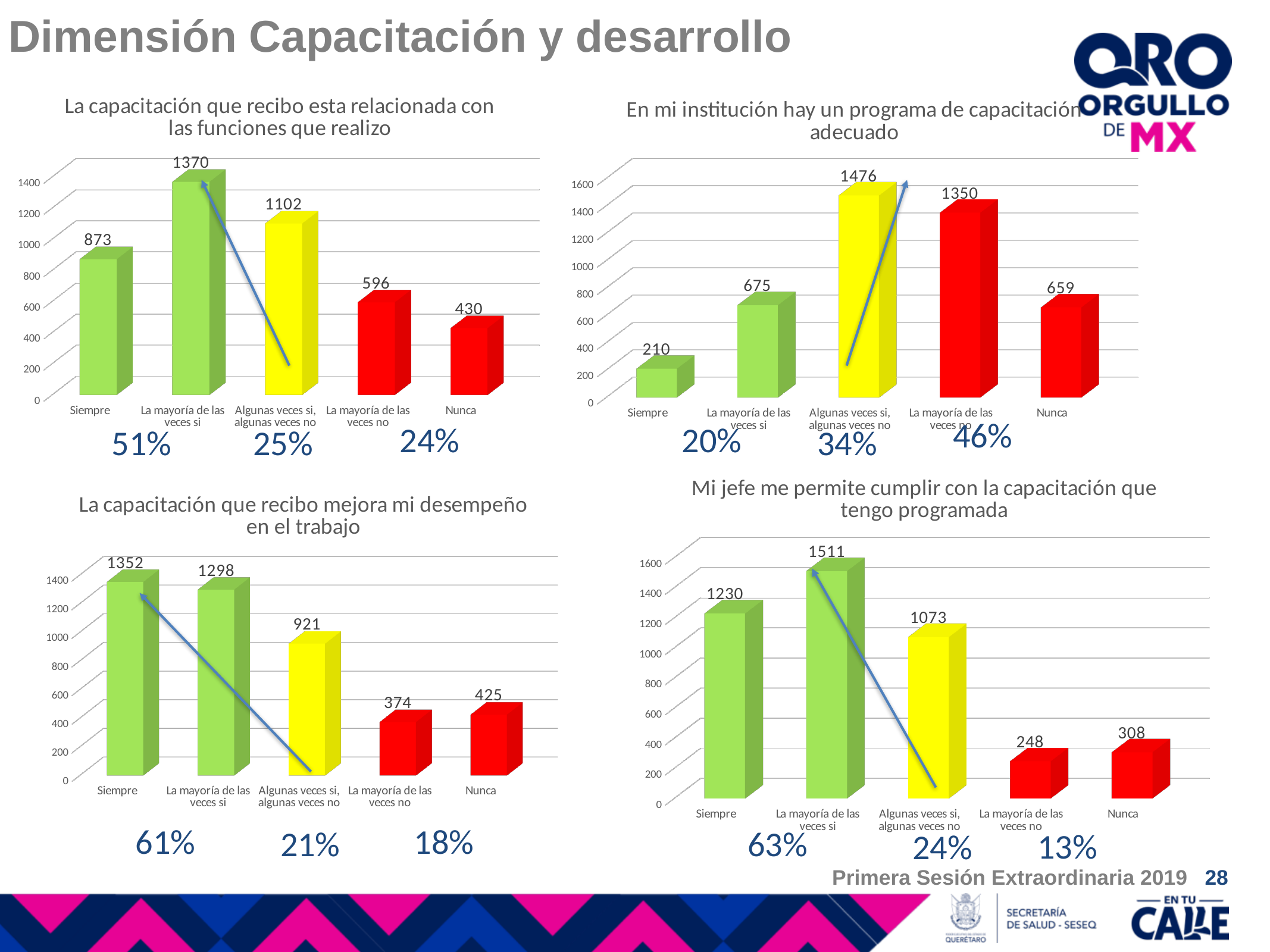
In the chart titled 'Mi jefe me permite cumplir con la capacitación que tengo programada', what is the value for 'La mayoría de las veces si'? 1511 In the chart titled 'En mi institución hay un programa de capacitación adecuado', what is the difference between 'Algunas veces si, algunas veces no' and 'La mayoría de las veces no'? 126 In the chart titled 'La capacitación que recibo esta relacionada con las funciones que realizo', what is the value for 'Siempre'? 873 In the chart titled 'Mi jefe me permite cumplir con la capacitación que tengo programada', which category has the lowest value? La mayoría de las veces no In the chart titled 'La capacitación que recibo esta relacionada con las funciones que realizo', which category has the highest value? La mayoría de las veces si In the chart titled 'En mi institución hay un programa de capacitación adecuado', what is the value for 'Nunca'? 659 In the chart titled 'La capacitación que recibo mejora mi desempeño en el trabajo', what is the value for 'Algunas veces si, algunas veces no'? 921 In the chart titled 'Mi jefe me permite cumplir con la capacitación que tengo programada', what is the difference between 'Siempre' and 'Algunas veces si, algunas veces no'? 157 In the chart titled 'La capacitación que recibo mejora mi desempeño en el trabajo', which is larger, 'La mayoría de las veces no' or 'Nunca'? Nunca How many categories does the chart titled 'La capacitación que recibo mejora mi desempeño en el trabajo' show? 5 What kind of chart is the chart titled 'En mi institución hay un programa de capacitación adecuado'? Bar chart In the chart titled 'En mi institución hay un programa de capacitación adecuado', which category has the lowest value? Siempre